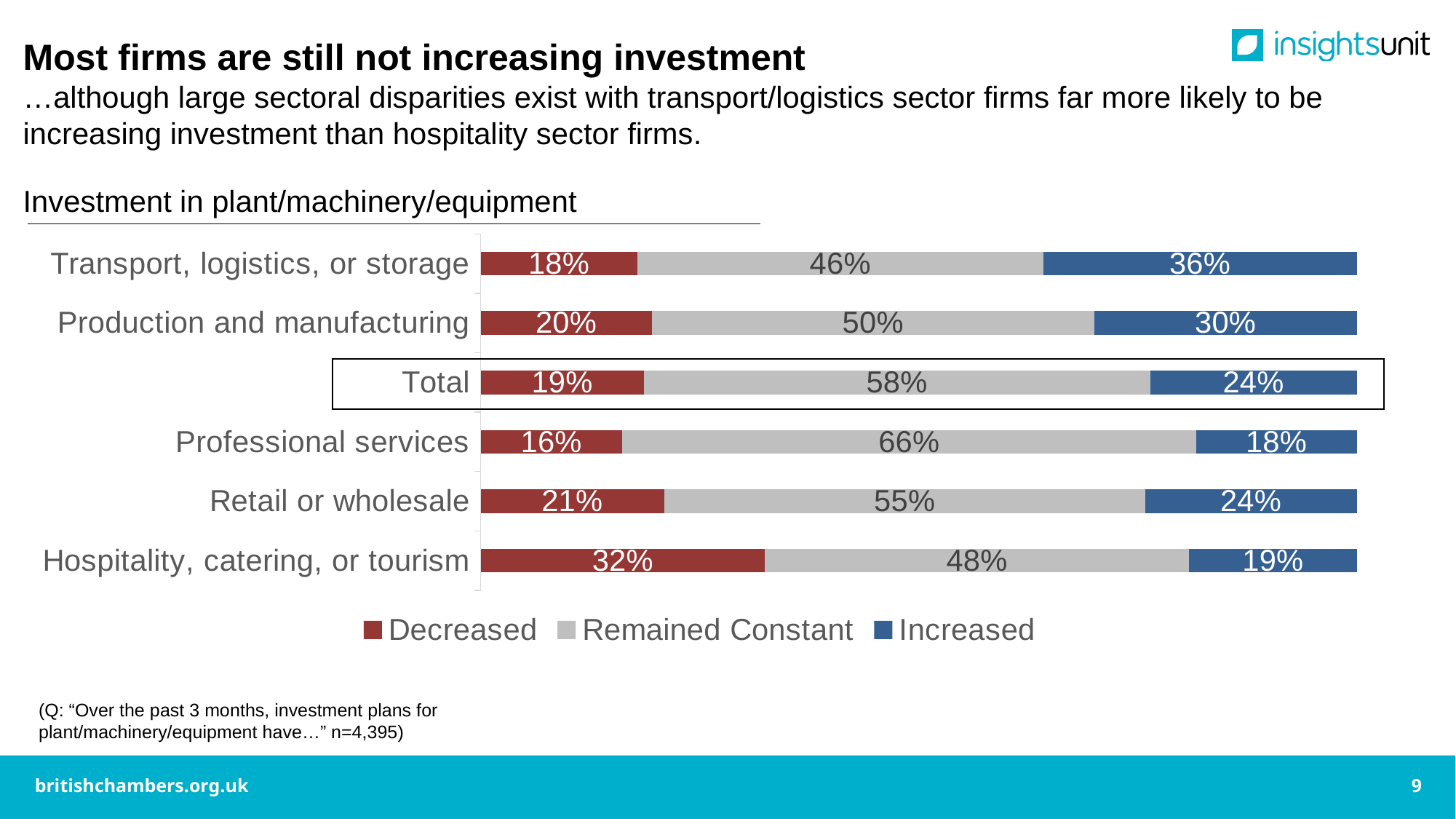
Which category has the lowest Decreased percentage? Professional services What kind of chart is shown on the slide? Stacked bar chart What percentage of Hospitality, catering, or tourism firms reported investment Decreased? 32% How many categories are shown on the chart? 6 How many series does the legend list? 3 What is the Increased value for the Total row? 24% Which colour represents the Decreased series in the chart? Red What percentage of Transport, logistics, or storage firms reported investment Increased? 36% Which category has the highest Increased percentage? Transport, logistics, or storage Which is larger: the Decreased value for Retail or wholesale or the Decreased value for Production and manufacturing? Retail or wholesale What is the difference between the Increased percentages for Transport, logistics, or storage and Hospitality, catering, or tourism? 17% What is the Remained Constant value for Professional services? 66%